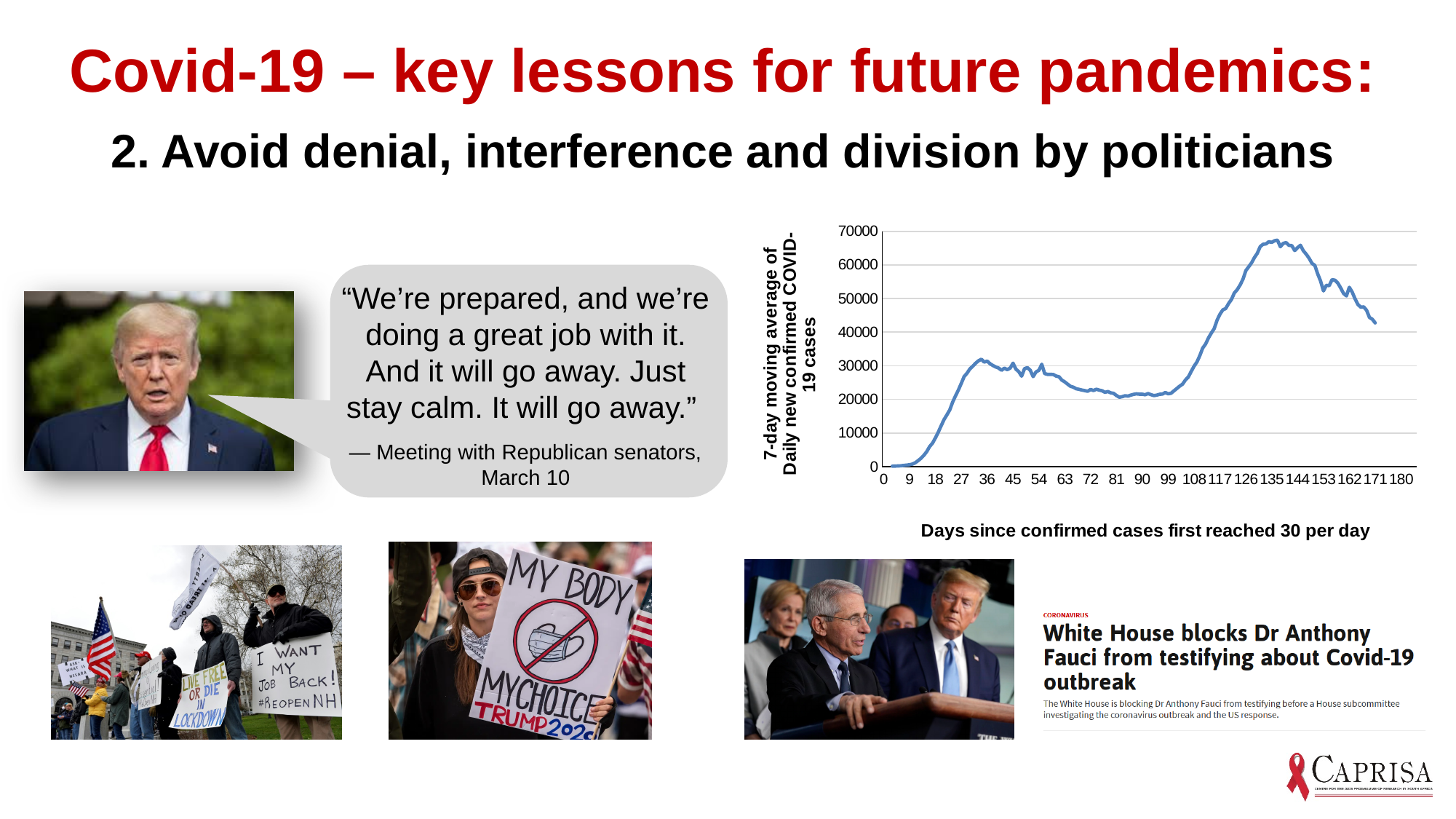
Does the line rise or fall between day 99 and day 135? rise Does the line rise or fall between day 135 and day 171? fall Is the value at day 54 greater or less than 40000? less What kind of chart is shown on the slide? line chart What is the label of the y axis of the chart? 7-day moving average of Daily new confirmed COVID-19 cases Is the value at day 135 greater or less than 60000? greater Is the value at day 171 greater or less than 50000? less Which is larger, the value at day 36 or the value at day 135? day 135 What is the label of the x axis of the chart? Days since confirmed cases first reached 30 per day